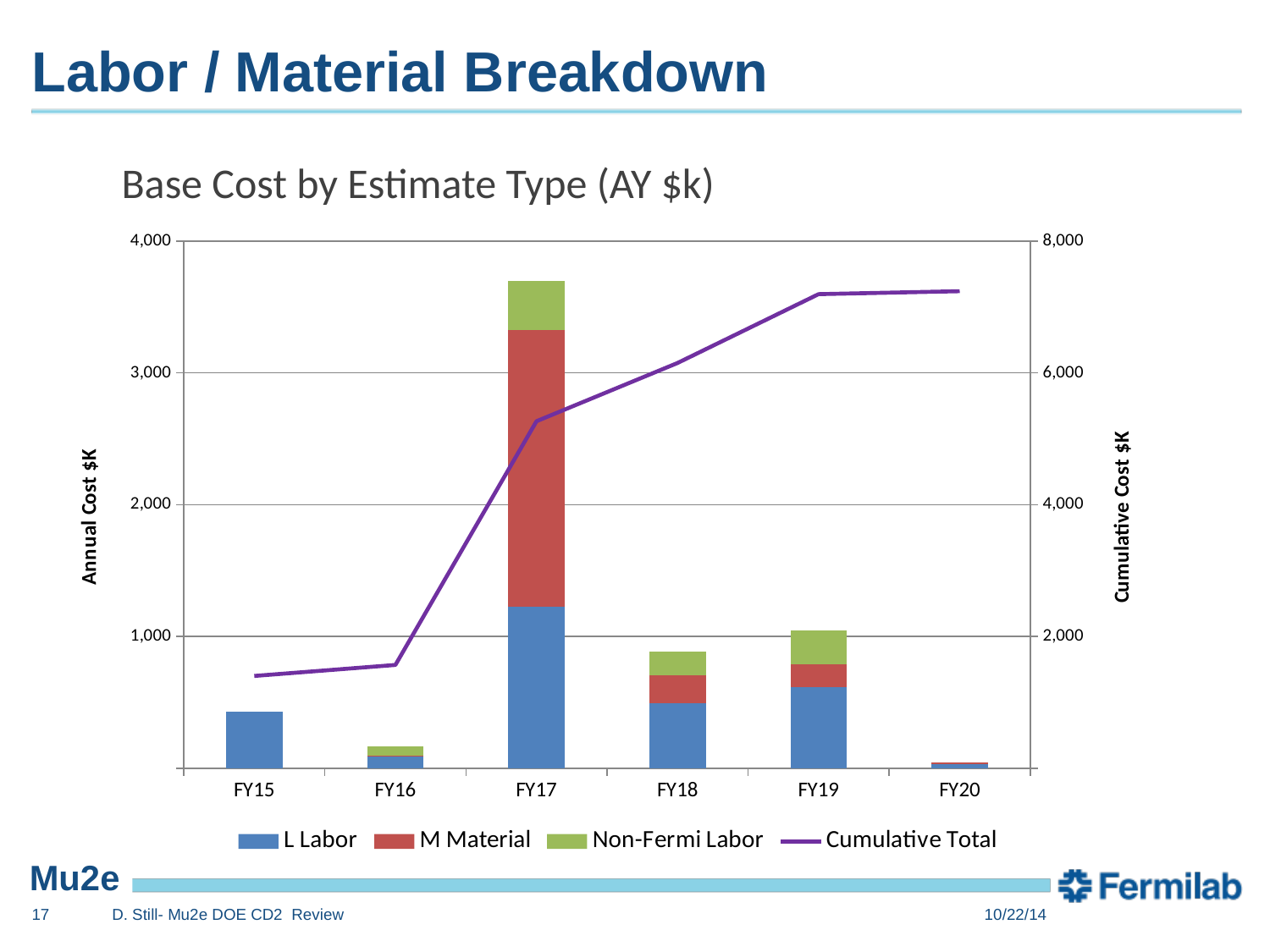
Which has the larger total annual cost bar, FY15 or FY16? FY15 Which fiscal year has the highest total annual cost bar? FY17 Which fiscal year has the lowest total annual cost bar? FY20 What is the title of the chart? Base Cost by Estimate Type (AY $k) How many series does the chart legend list? 4 Does the Cumulative Total line rise or fall from FY15 to FY20? rise Which series makes up the largest portion of the FY17 bar? M Material What kind of chart is this? Stacked bar chart with a line How many fiscal year categories are shown on the x axis? 6 Is the total annual cost bar for FY17 greater or less than 3,000? greater Is the total annual cost bar for FY15 greater or less than 1,000? less Is the Cumulative Total at FY19 greater or less than 6,000? greater